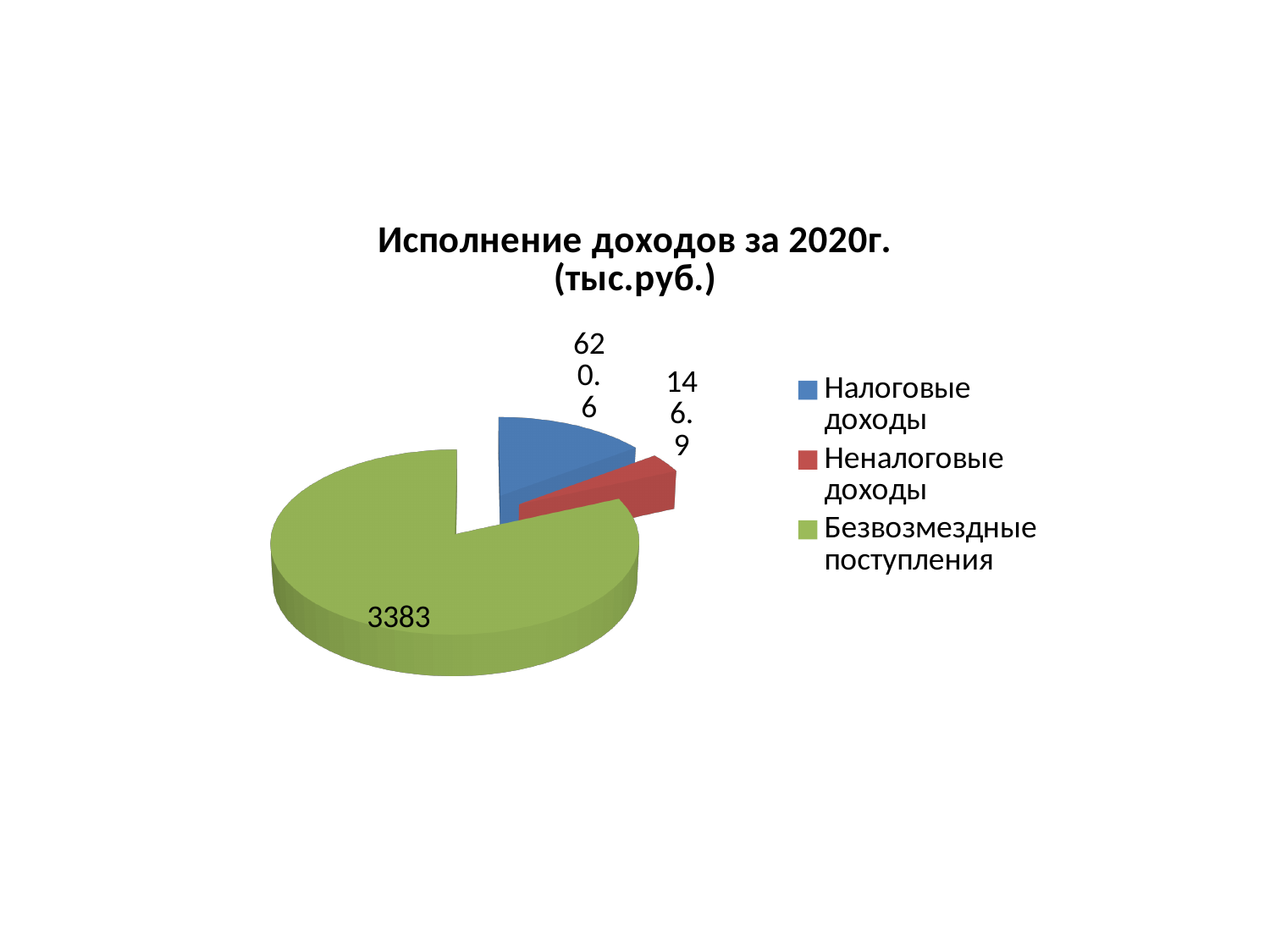
Which is larger, Налоговые доходы or Неналоговые доходы? Налоговые доходы Which category has the largest slice of the pie? Безвозмездные поступления What is the difference between Налоговые доходы and Неналоговые доходы? 473.7 What is the value for Налоговые доходы? 620.6 What is the difference between Безвозмездные поступления and Налоговые доходы? 2762.4 What is the value for Неналоговые доходы? 146.9 Which category has the smallest slice of the pie? Неналоговые доходы Which colour represents Безвозмездные поступления in the legend? Green What is the title of the chart? Исполнение доходов за 2020г. (тыс.руб.) How many categories does the pie chart show? 3 What is the value for Безвозмездные поступления? 3383 What type of chart is shown on the slide? Pie chart